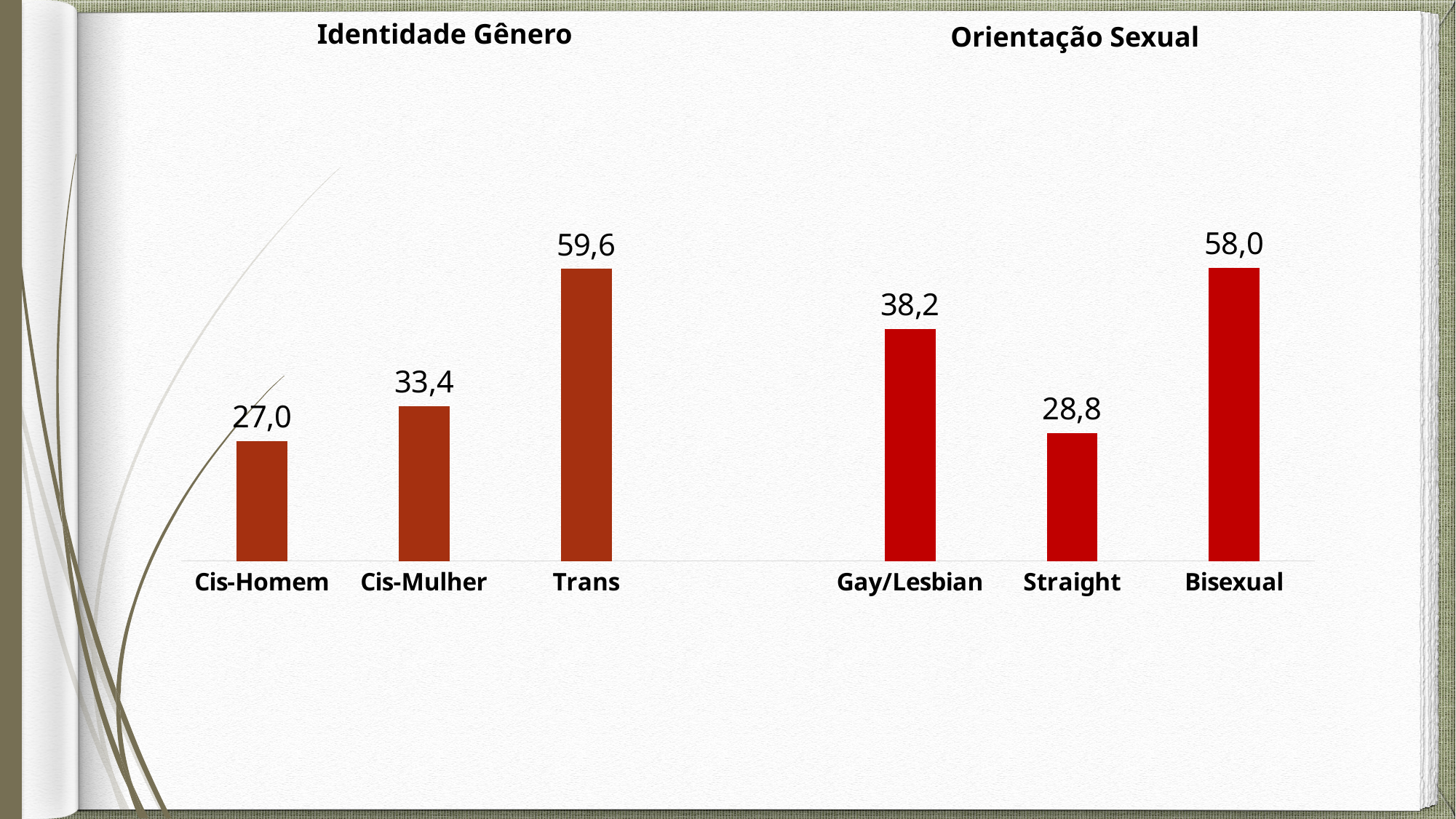
In the Orientação Sexual chart, which category has the highest value? Bisexual In the Orientação Sexual chart, what is the difference between the values for Bisexual and Straight? 29,2 In the Orientação Sexual chart, which is larger, the value for Gay/Lesbian or the value for Straight? Gay/Lesbian In the Identidade Gênero chart, which category has the lowest value? Cis-Homem In the Identidade Gênero chart, what is the value for Trans? 59,6 How many categories are shown in the Identidade Gênero chart? 3 In the Identidade Gênero chart, what is the difference between the values for Trans and Cis-Homem? 32,6 In the Identidade Gênero chart, which category has the highest value? Trans In the Orientação Sexual chart, what is the value for Gay/Lesbian? 38,2 In the Identidade Gênero chart, what is the value for Cis-Homem? 27,0 In the Orientação Sexual chart, which category has the lowest value? Straight In the Orientação Sexual chart, what is the value for Straight? 28,8